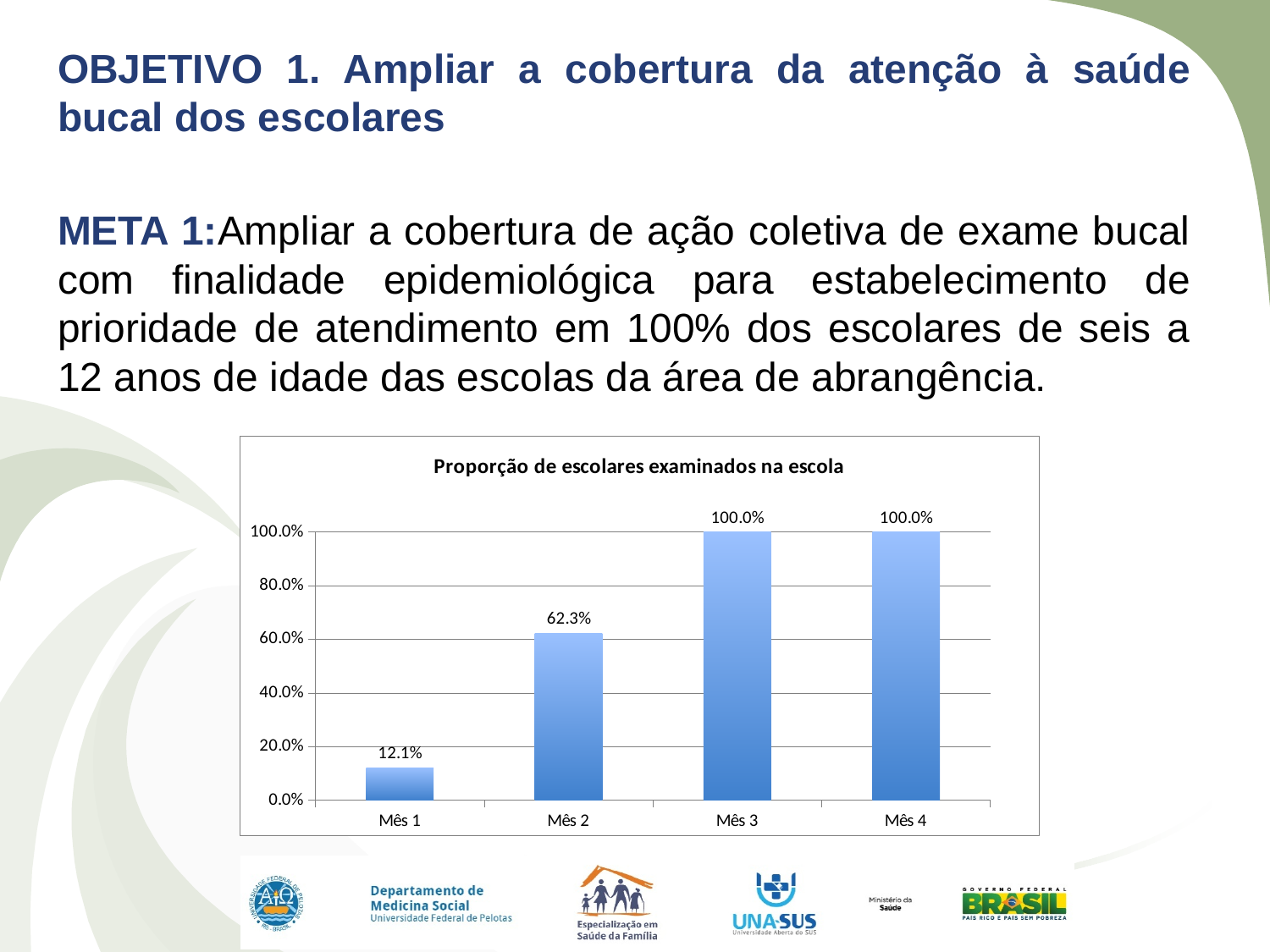
What is the difference between the values for Mês 3 and Mês 2? 37.7% What is the value for Mês 3? 100.0% What is the difference between the values for Mês 2 and Mês 1? 50.2% Which is larger, the value for Mês 2 or the value for Mês 1? Mês 2 Do the values rise or fall from Mês 1 to Mês 3? rise What is the value for Mês 1? 12.1% Is the value for Mês 2 greater or less than 60.0%? greater What is the title of the chart? Proporção de escolares examinados na escola What is the value for Mês 2? 62.3% How many categories are shown on the x axis? 4 What kind of chart is shown on the slide? bar chart Which category has the lowest value? Mês 1